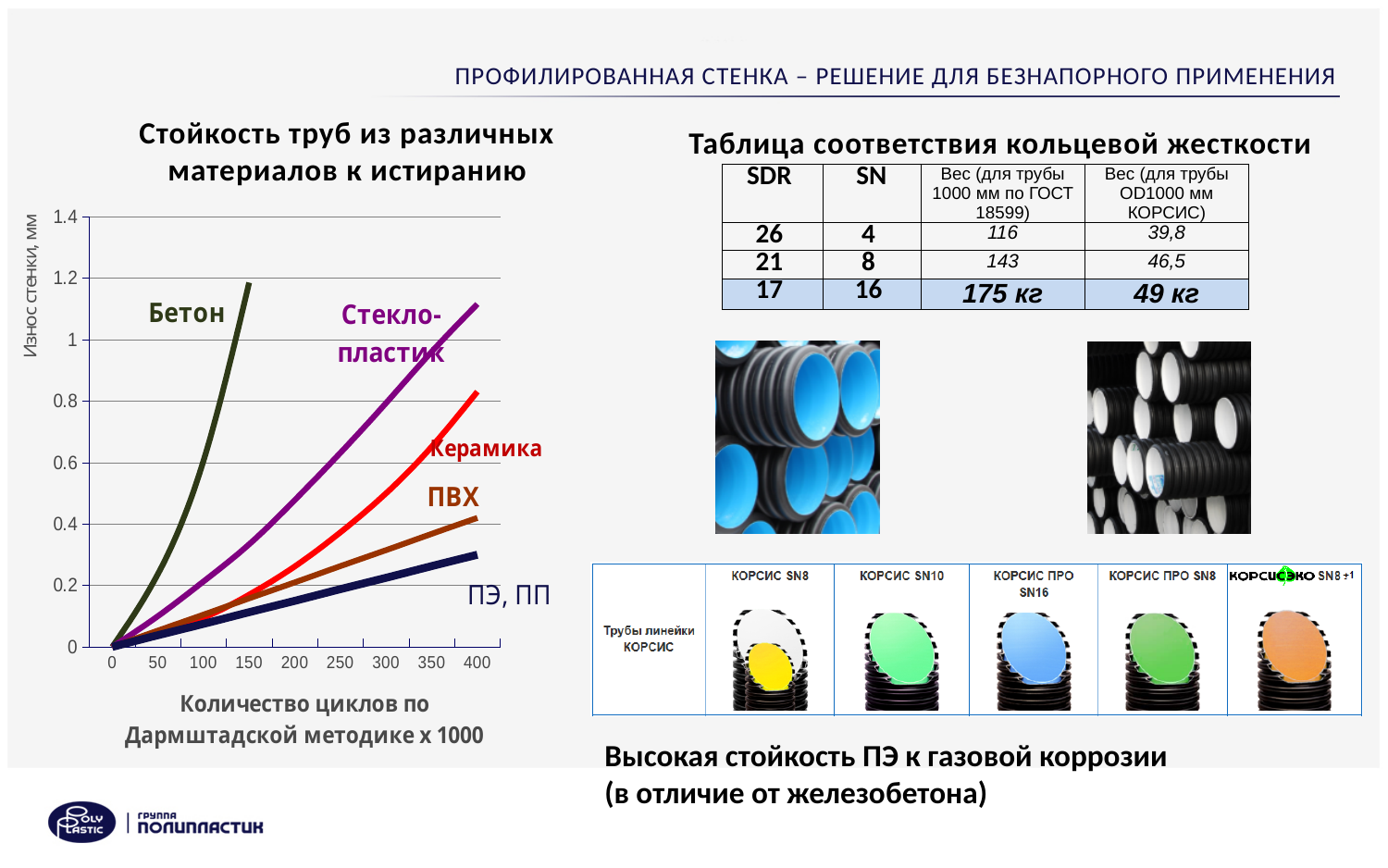
Is the wall wear for ПВХ at 400 thousand cycles greater or less than 0.6 mm? less What is the title of the chart on the left of the slide? Стойкость труб из различных материалов к истиранию How many pipe materials (lines) are plotted in the chart? 5 Does wall wear rise or fall as the number of cycles increases in the chart? rise What is the label of the vertical axis of the chart? Износ стенки, мм Is the wall wear for Стеклопластик at 400 thousand cycles greater or less than 1 mm? greater Is the wall wear for Бетон at 150 thousand cycles greater or less than 1 mm? greater What kind of chart is shown on the left of the slide? line chart At 400 thousand cycles, which has higher wall wear in the chart: Керамика or ПВХ? Керамика Which material shows the lowest wall wear across the whole range of cycles in the chart? ПЭ, ПП At 100 thousand cycles, which has higher wall wear in the chart: Бетон or Стеклопластик? Бетон Which material's line reaches the highest wall wear at 400 thousand cycles in the chart? Стеклопластик